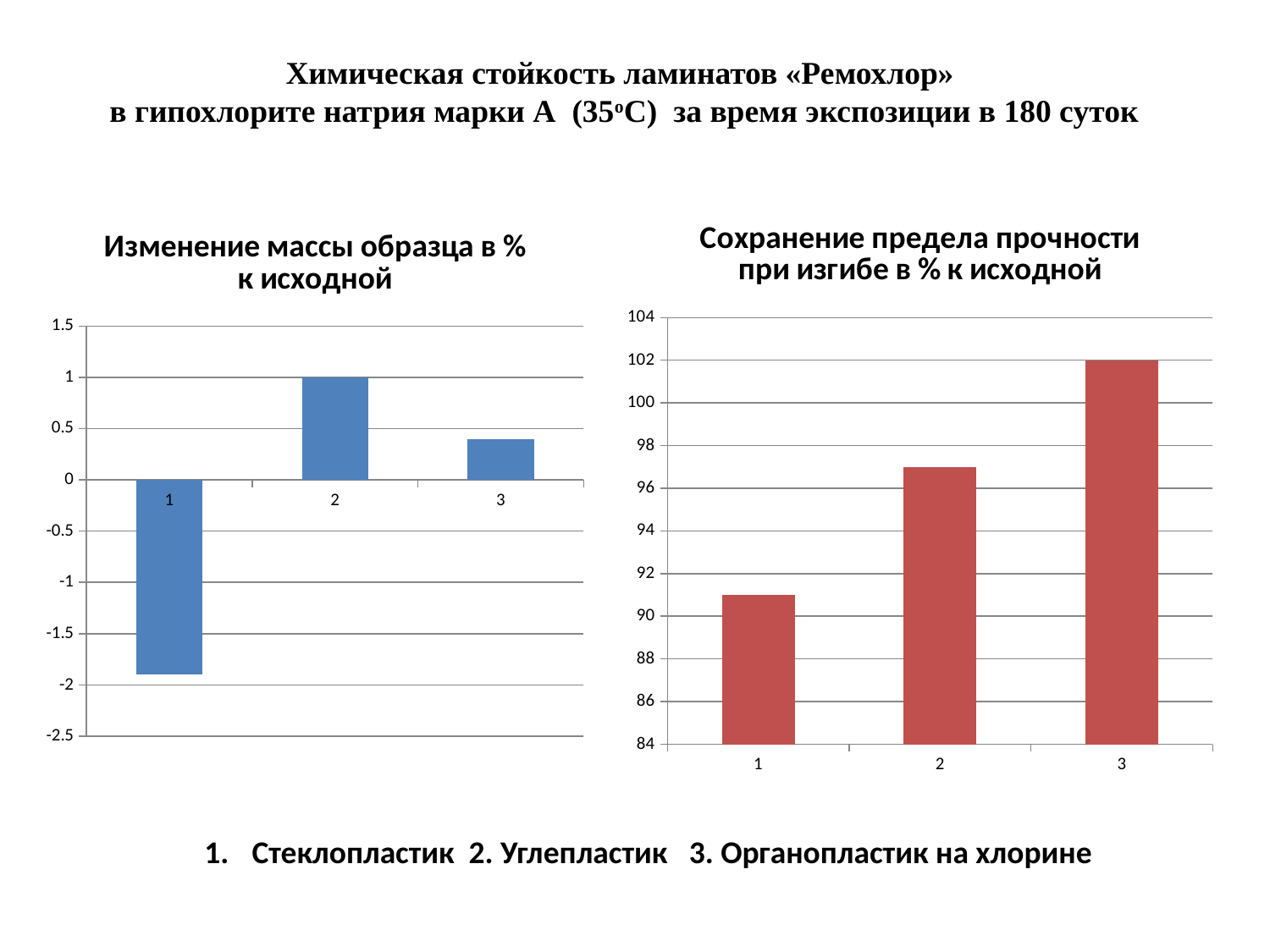
In the left chart (Изменение массы образца), which category has the lowest value? 1 In the right chart (Сохранение предела прочности), which category has the highest value? 3 In the chart titled "Сохранение предела прочности при изгибе в % к исходной", what is the value for category 3? 102 What kind of chart is the right chart (Сохранение предела прочности)? bar chart How many categories are shown in the left chart (Изменение массы образца)? 3 In the right chart (Сохранение предела прочности), which category has the lowest value? 1 In the chart titled "Изменение массы образца в % к исходной", what is the value for category 2? 1 In the right chart (Сохранение предела прочности), do the values rise or fall from category 1 to category 3? rise In the left chart (Изменение массы образца), which category has the highest value? 2 In the right chart (Сохранение предела прочности), is the value for category 2 greater or less than 98? less In the right chart (Сохранение предела прочности), is the value for category 1 greater or less than 90? greater In the left chart (Изменение массы образца), is the value for category 1 greater or less than -1.5? less